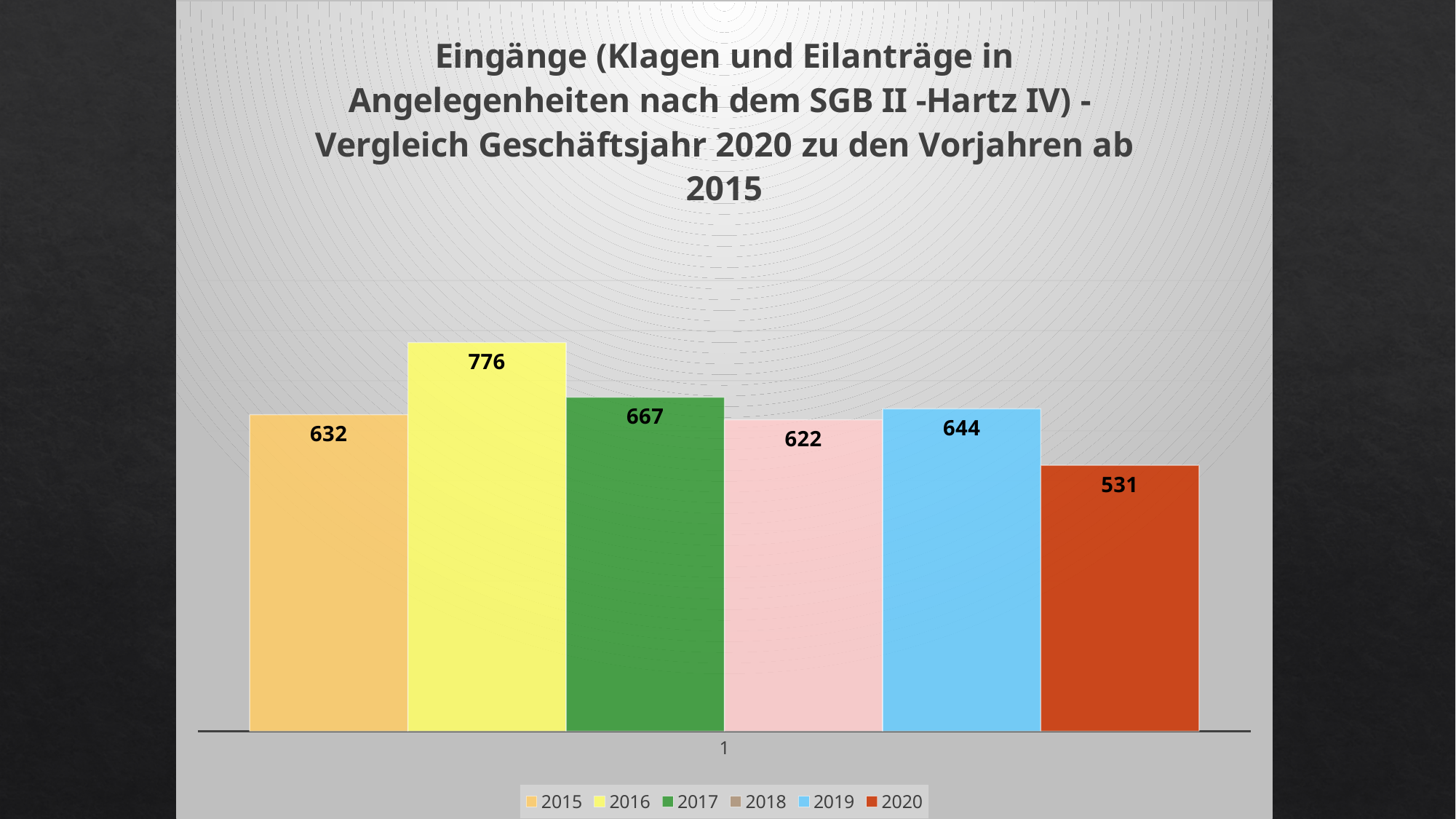
What is the value for 2016? 776 What is the value for 2020? 531 Which year has the lowest value? 2020 Do the values rise or fall from 2019 to 2020? fall What is the difference between the values for 2016 and 2020? 245 What kind of chart is shown? bar chart What is the difference between the values for 2017 and 2019? 23 How many series does the legend list? 6 Which year has the highest value? 2016 Which is larger, the value for 2015 or the value for 2019? 2019 What is the value for 2018? 622 What colour is the bar for 2017? green